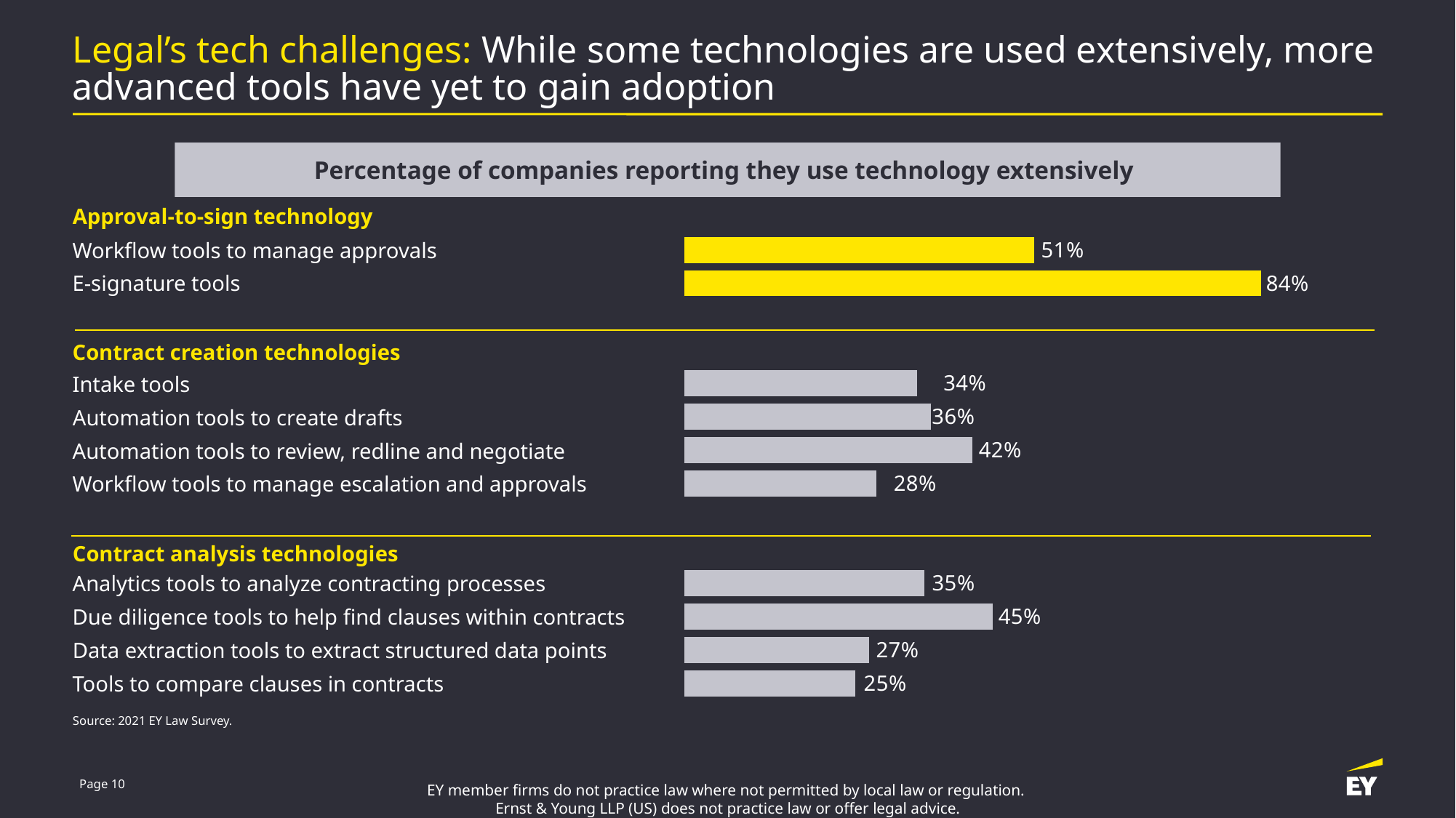
In the Approval-to-sign technology chart, what is the difference between E-signature tools and Workflow tools to manage approvals? 33 percentage points In the Contract analysis technologies chart, which category has the highest value? Due diligence tools to help find clauses within contracts What kind of chart is used on this slide to show the percentages? Bar chart In the Contract creation technologies chart, which category has the lowest value? Workflow tools to manage escalation and approvals In the Approval-to-sign technology chart, what percentage of companies report using E-signature tools extensively? 84% How many categories are shown in the Contract analysis technologies chart? 4 In the Contract creation technologies chart, which is larger: Intake tools or Automation tools to create drafts? Automation tools to create drafts In the Contract creation technologies chart, what is the value for Automation tools to review, redline and negotiate? 42% In the Contract analysis technologies chart, what is the value for Data extraction tools to extract structured data points? 27% In the Contract analysis technologies chart, what is the difference between Due diligence tools to help find clauses within contracts and Tools to compare clauses in contracts? 20 percentage points How many categories are shown in the Contract creation technologies chart? 4 What colour are the bars in the Approval-to-sign technology chart? Yellow